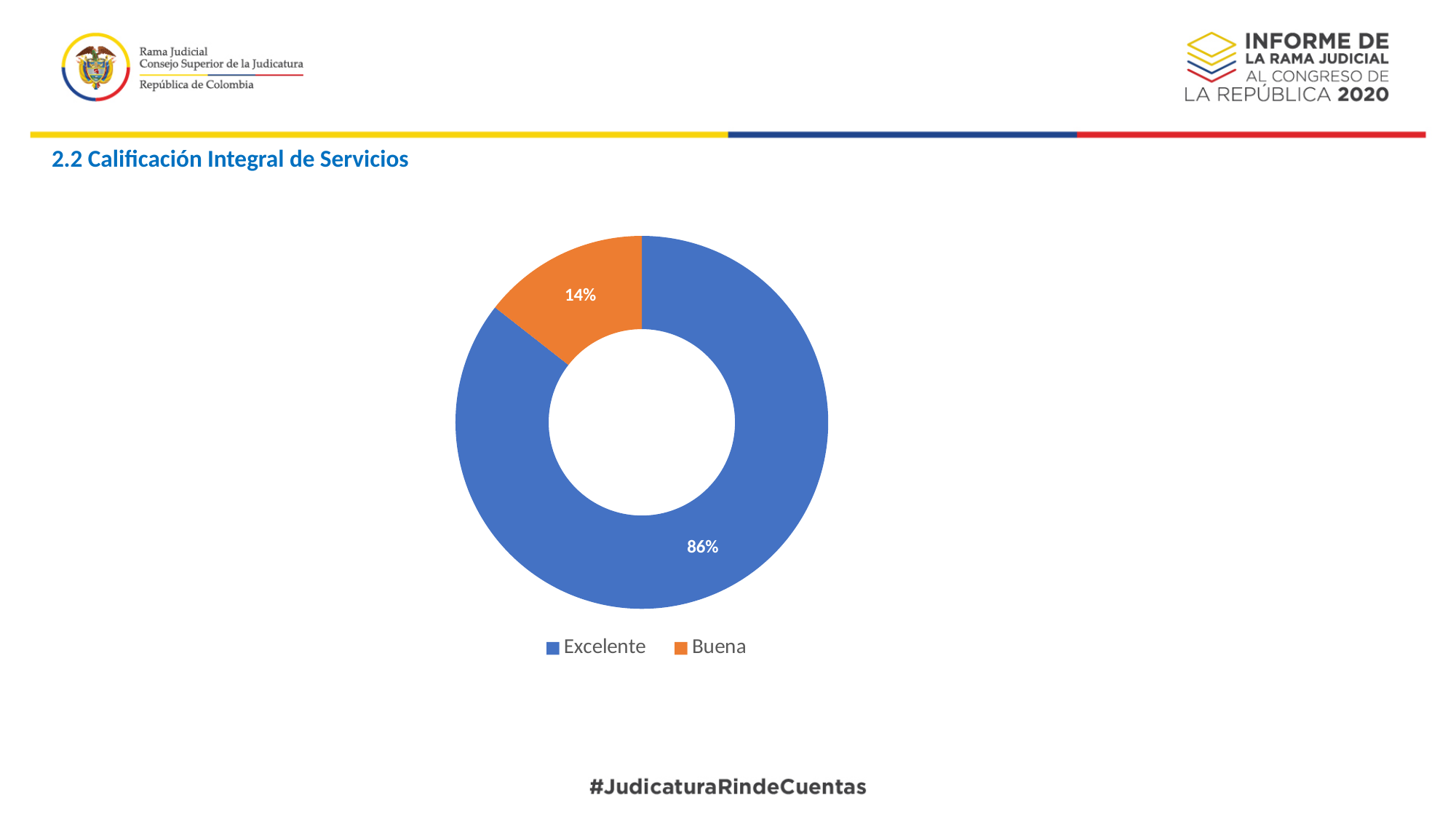
What is the difference in percentage points between Excelente and Buena? 72 Which category has the largest share of the chart? Excelente What colour is the Buena slice? Orange What kind of chart is shown on the slide? Pie chart (doughnut) What share of the pie does Excelente represent? 86% Which category has the smallest share of the chart? Buena What share of the pie does Buena represent? 14% How many categories are shown in the chart? 2 Which is larger, the share for Excelente or the share for Buena? Excelente What is the title of the section shown above the chart? 2.2 Calificación Integral de Servicios